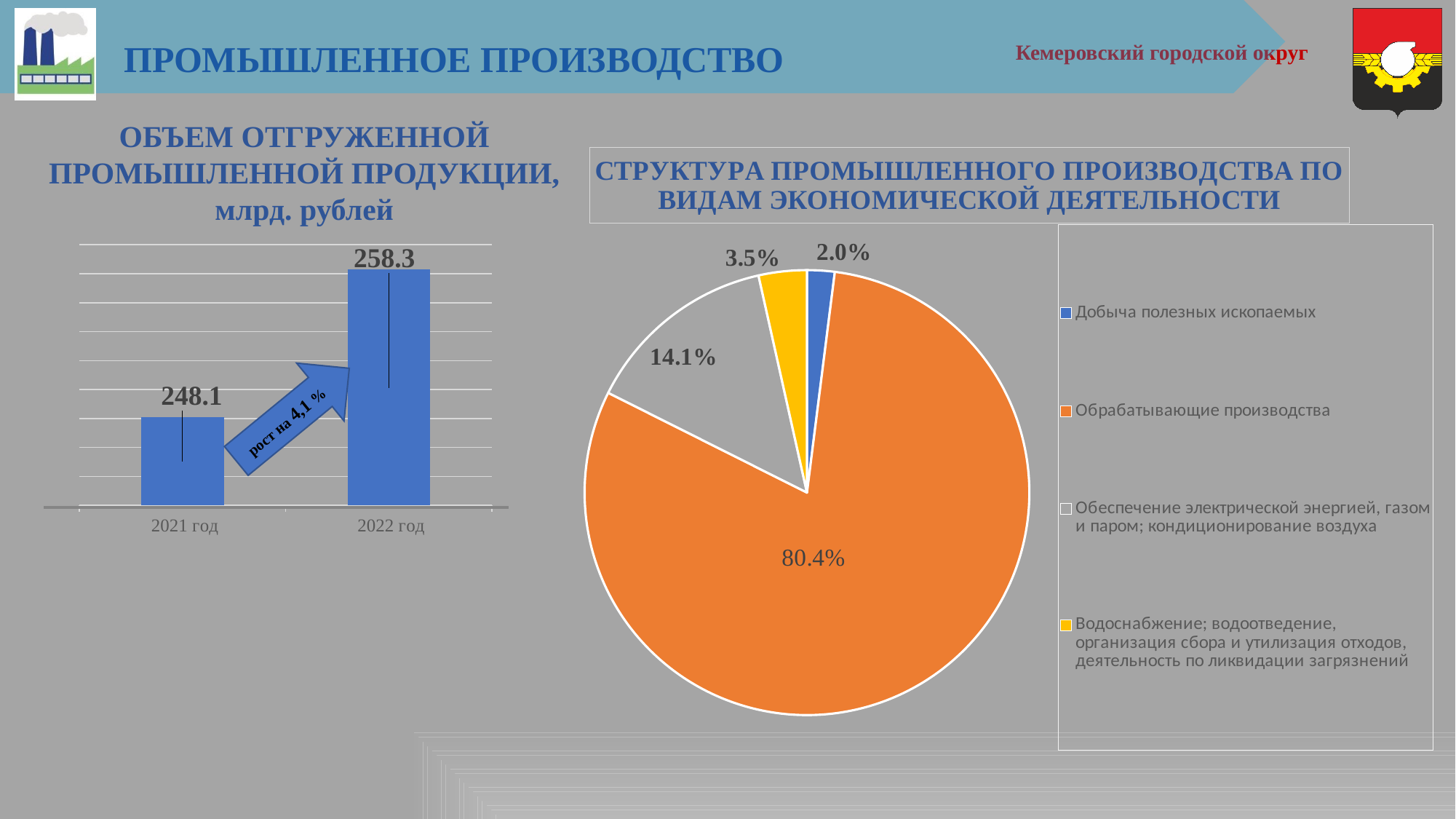
In the pie chart on the right (СТРУКТУРА ПРОМЫШЛЕННОГО ПРОИЗВОДСТВА), what share does Обрабатывающие производства have? 80.4% In the bar chart on the left, how many bars are plotted? 2 In the bar chart on the left, what is the value for 2022 год? 258.3 In the pie chart on the right, how many categories does the legend list? 4 What kind of chart is the one on the left of the slide? Bar chart In the pie chart on the right, what share does Добыча полезных ископаемых have? 2.0% In the bar chart on the left, what is the difference between the 2022 год and 2021 год values? 10.2 In the bar chart on the left (ОБЪЕМ ОТГРУЖЕННОЙ ПРОМЫШЛЕННОЙ ПРОДУКЦИИ), what is the value for 2021 год? 248.1 In the pie chart on the right, which category has the smallest share? Добыча полезных ископаемых In the bar chart on the left, do the values rise or fall from 2021 год to 2022 год? Rise In the pie chart on the right, what colour is the slice for Водоснабжение; водоотведение, организация сбора и утилизация отходов, деятельность по ликвидации загрязнений? Yellow In the bar chart on the left, which year has the higher value? 2022 год